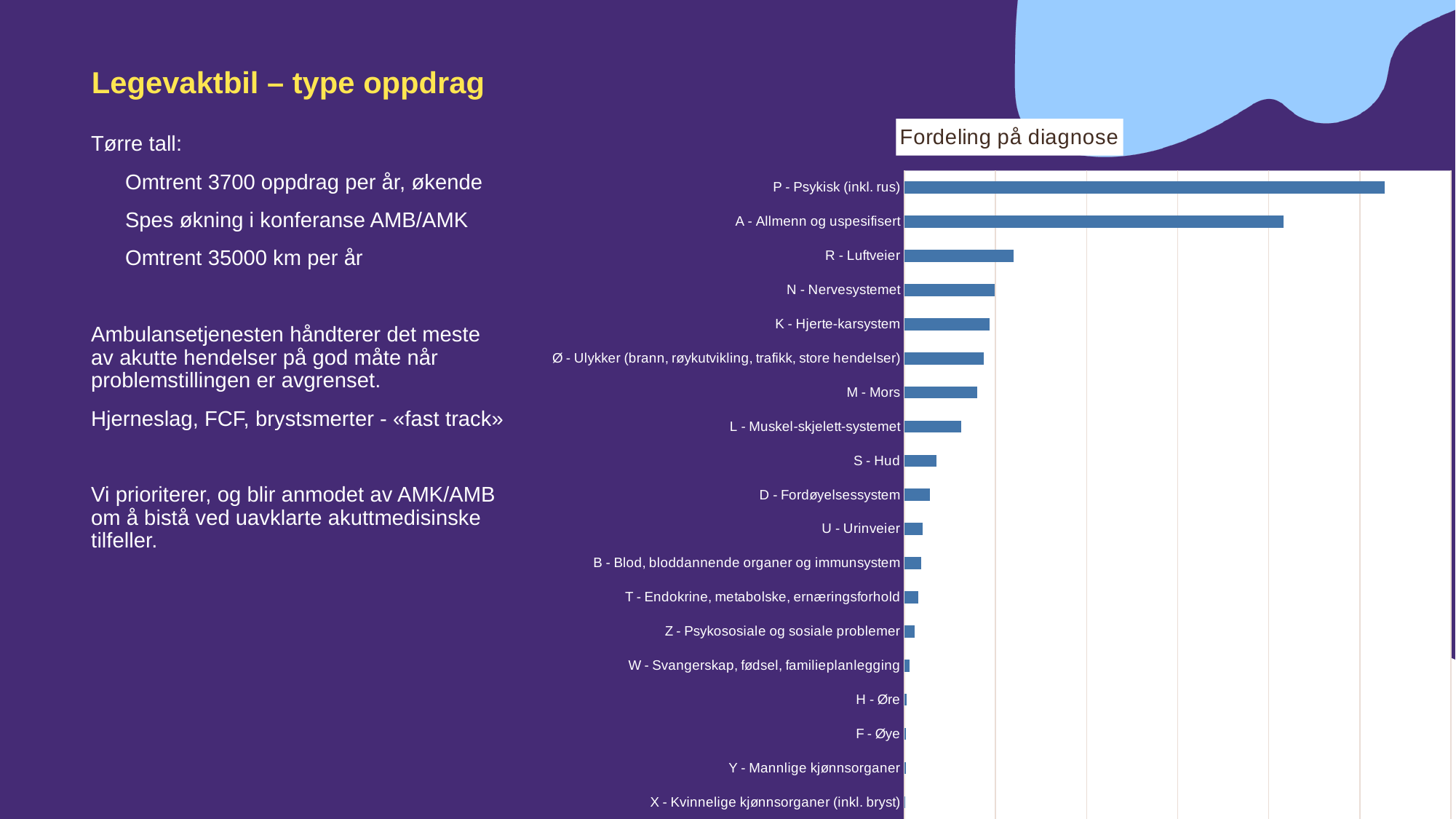
Which category has the second-longest bar in the chart? A - Allmenn og uspesifisert What type of chart is shown on the slide? Bar chart Which has the longer bar: R - Luftveier or N - Nervesystemet? R - Luftveier How many diagnosis categories are shown in the chart? 19 Which has the longer bar: A - Allmenn og uspesifisert or R - Luftveier? A - Allmenn og uspesifisert Which diagnosis category has the longest bar in the chart? P - Psykisk (inkl. rus) Do the bar lengths increase or decrease going from the top category to the bottom category? Decrease Which has the longer bar: M - Mors or L - Muskel-skjelett-systemet? M - Mors What is the title of the chart? Fordeling på diagnose What colour are the bars in the chart? Blue